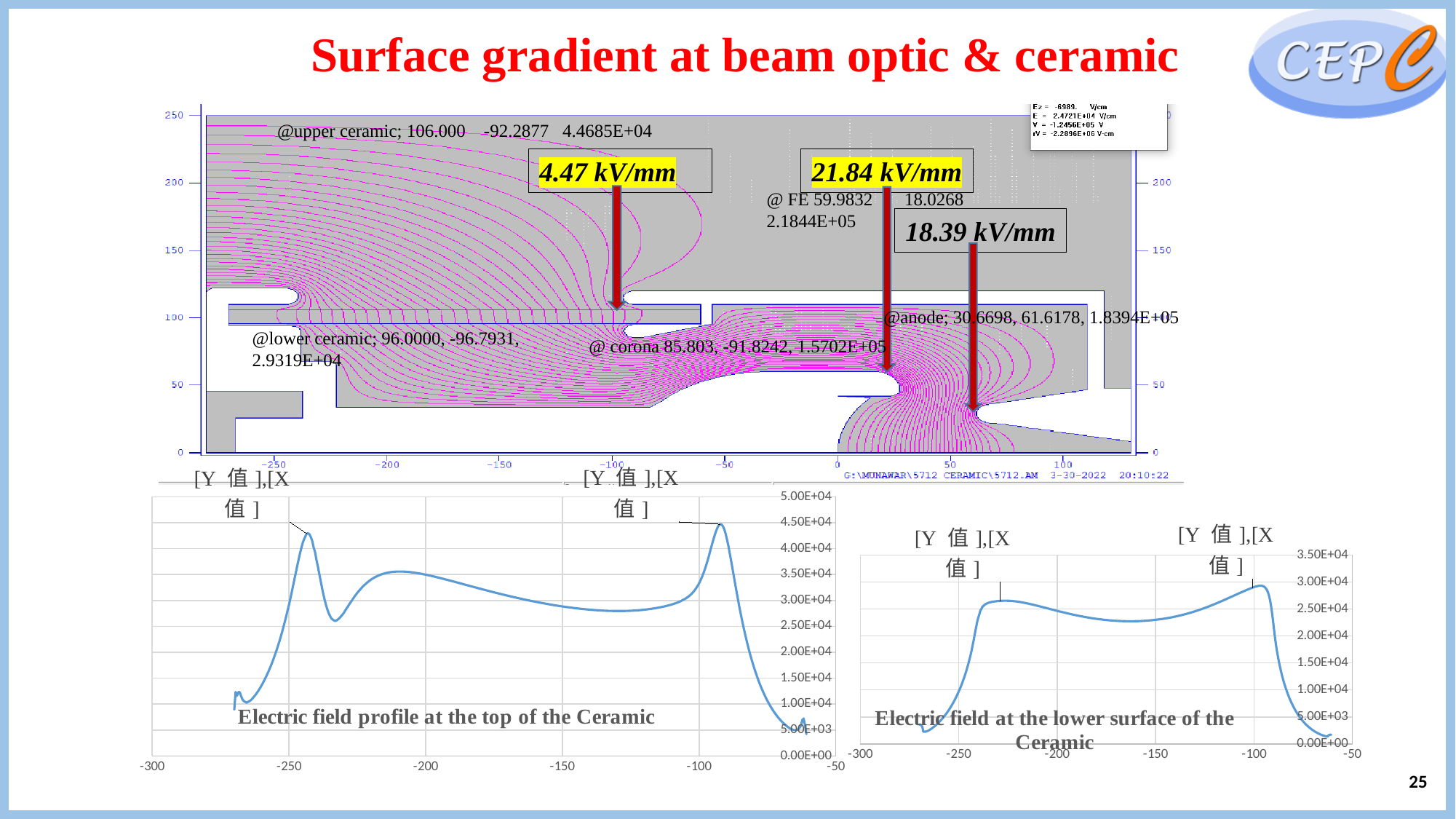
What kind of chart is 'Electric field profile at the top of the Ceramic'? line chart In the chart 'Electric field at the lower surface of the Ceramic', does the curve rise or fall between x = -100 and x = -50? fall In the chart 'Electric field at the lower surface of the Ceramic', what is the highest value shown on the y axis? 3.50E+04 In the chart 'Electric field at the lower surface of the Ceramic', is the value at x = -60 greater or less than 1.00E+04? less In the field map at the top of the slide, which of the three labelled surface gradients is the highest? 21.84 kV/mm In the chart 'Electric field at the lower surface of the Ceramic', is the peak value near x = -100 greater or less than 2.50E+04? greater In the field map at the top of the slide, what surface gradient is labelled at the upper ceramic? 4.47 kV/mm In the chart 'Electric field profile at the top of the Ceramic', what is the highest value shown on the y axis? 5.00E+04 In the chart 'Electric field profile at the top of the Ceramic', does the curve rise or fall between x = -270 and x = -245? rise In the chart 'Electric field profile at the top of the Ceramic', is the value at x = -200 greater or less than 2.50E+04? greater What kind of chart is 'Electric field at the lower surface of the Ceramic'? line chart